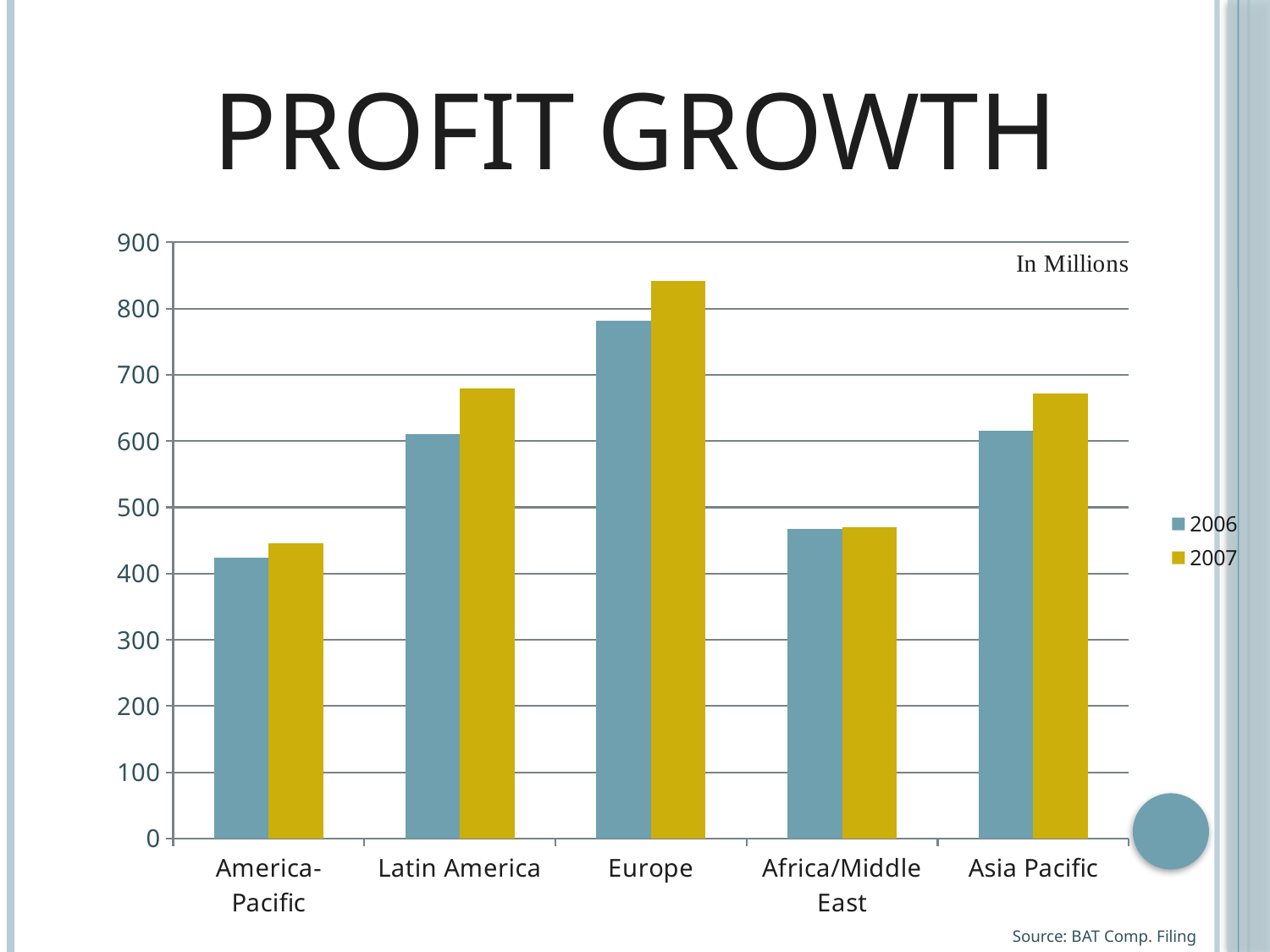
Which region has the lowest profit in 2006? America-Pacific What kind of chart is shown on the slide? bar chart Which is larger: the 2006 value for Europe or the 2006 value for Latin America? Europe How many series does the legend list? 2 Is the 2007 value for Europe greater or less than 800? greater Is the 2007 value for Africa/Middle East greater or less than 500? less Is the 2007 value for Asia Pacific greater or less than 700? less Which is larger: the 2007 value for Latin America or the 2007 value for America-Pacific? Latin America What is the title of the chart? PROFIT GROWTH Which region has the highest profit in 2007? Europe How many regions are shown on the x axis? 5